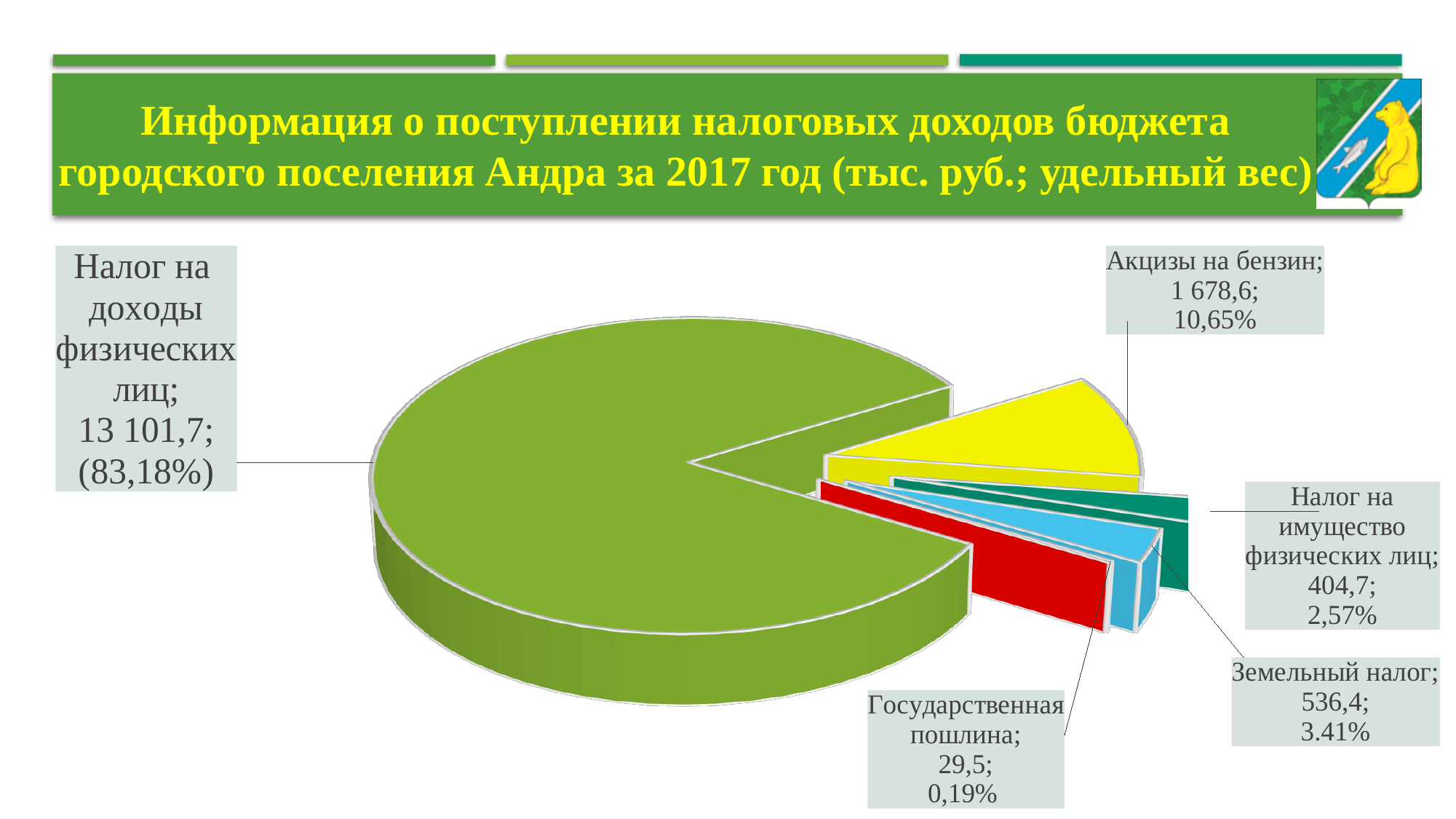
What is the value for Налог на доходы физических лиц? 13 101,7 Which category has the largest slice of the pie? Налог на доходы физических лиц Which category has the smallest slice of the pie? Государственная пошлина What type of chart is shown on the slide? Pie chart What colour is the slice for Акцизы на бензин? Yellow What share of the pie does Акцизы на бензин represent? 10,65% What share of the pie does Налог на имущество физических лиц represent? 2,57% Which is larger, Земельный налог or Налог на имущество физических лиц? Земельный налог What is the difference between the values for Акцизы на бензин and Земельный налог? 1 142,2 How many slices does the pie chart have? 5 What share of the pie does Государственная пошлина represent? 0,19% What is the value for Земельный налог? 536,4